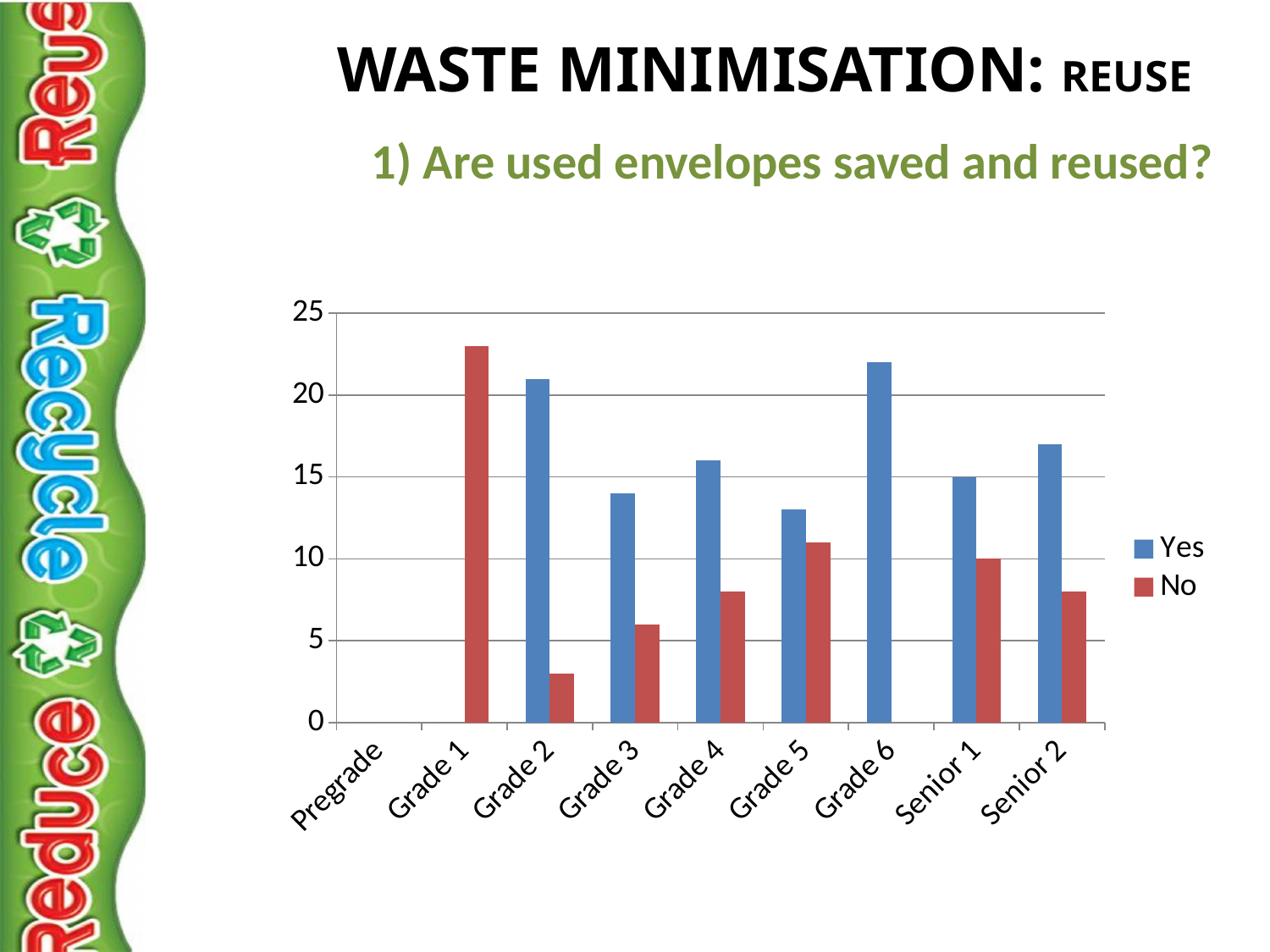
Which is larger, the Yes value for Grade 6 or the Yes value for Senior 1? Grade 6 Which category has the highest No value? Grade 1 Is the No value for Grade 1 greater or less than 20? greater What kind of chart is shown on the slide? bar chart How many series does the legend list? 2 Which is larger for Grade 4, the Yes value or the No value? Yes What colour are the No bars? red Is the No value for Grade 2 greater or less than 5? less Which is larger for Senior 2, the Yes value or the No value? Yes Is the Yes value for Grade 2 greater or less than 20? greater How many categories are shown on the x axis? 9